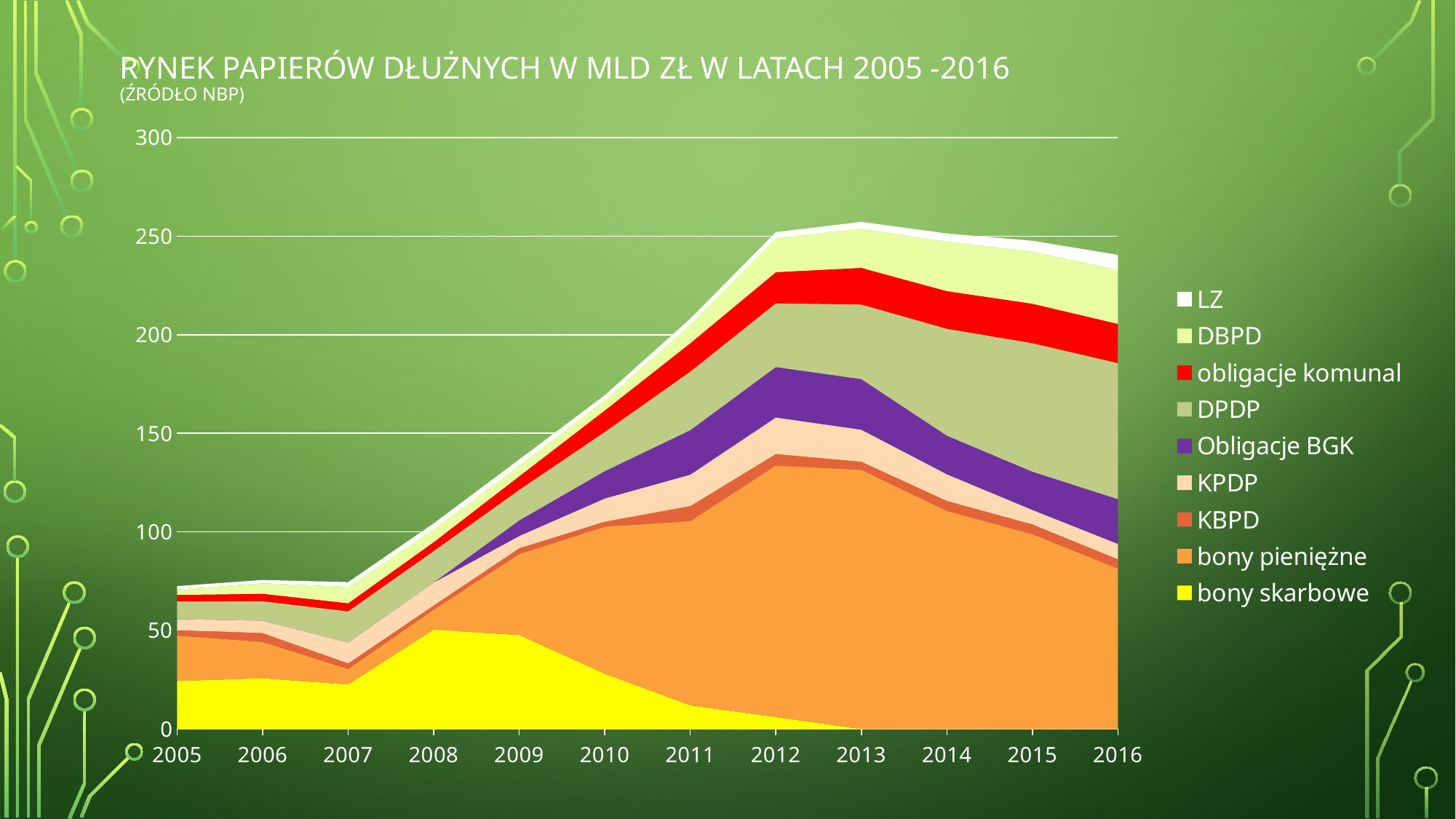
Is the total value of all series in 2016 greater or less than 250? less Does the value for bony skarbowe rise or fall between 2009 and 2016? fall How many series does the legend list? 9 Is the total value of all series in 2010 greater or less than 150? greater Is the total value of all series in 2013 greater or less than 250? greater What kind of chart is shown on the slide? stacked area chart How many years are plotted along the x axis? 12 In which year does the total of all series reach its highest point? 2013 Which series is listed first (at the top) in the legend? LZ Does the total of all series rise or fall between 2007 and 2012? rise